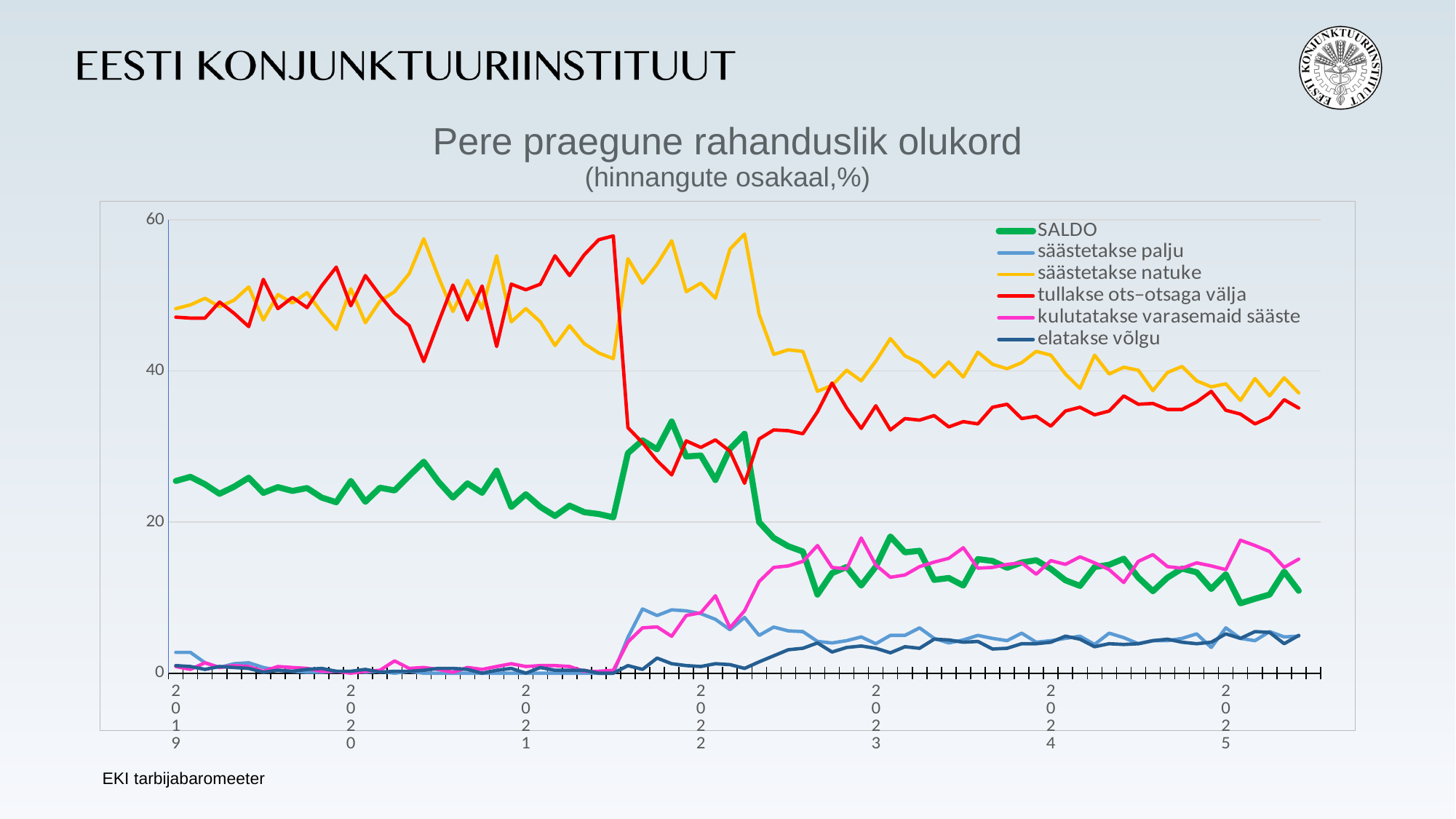
Does the SALDO series overall rise or fall from 2019 to 2025? fall Which series is drawn in red? tullakse ots–otsaga välja Is the value of SALDO at the end of 2025 greater or less than 20? less What is the title of the chart? Pere praegune rahanduslik olukord How many series does the legend list? 6 What kind of chart is shown on the slide? line chart At the end of 2025, which is larger: 'tullakse ots–otsaga välja' or SALDO? tullakse ots–otsaga välja Is the value of 'elatakse võlgu' during 2019 greater or less than 20? less How many year labels are shown on the x axis? 7 At the start of 2019, which is larger: 'säästetakse natuke' or 'elatakse võlgu'? säästetakse natuke Is the value of SALDO at the start of 2019 greater or less than 20? greater